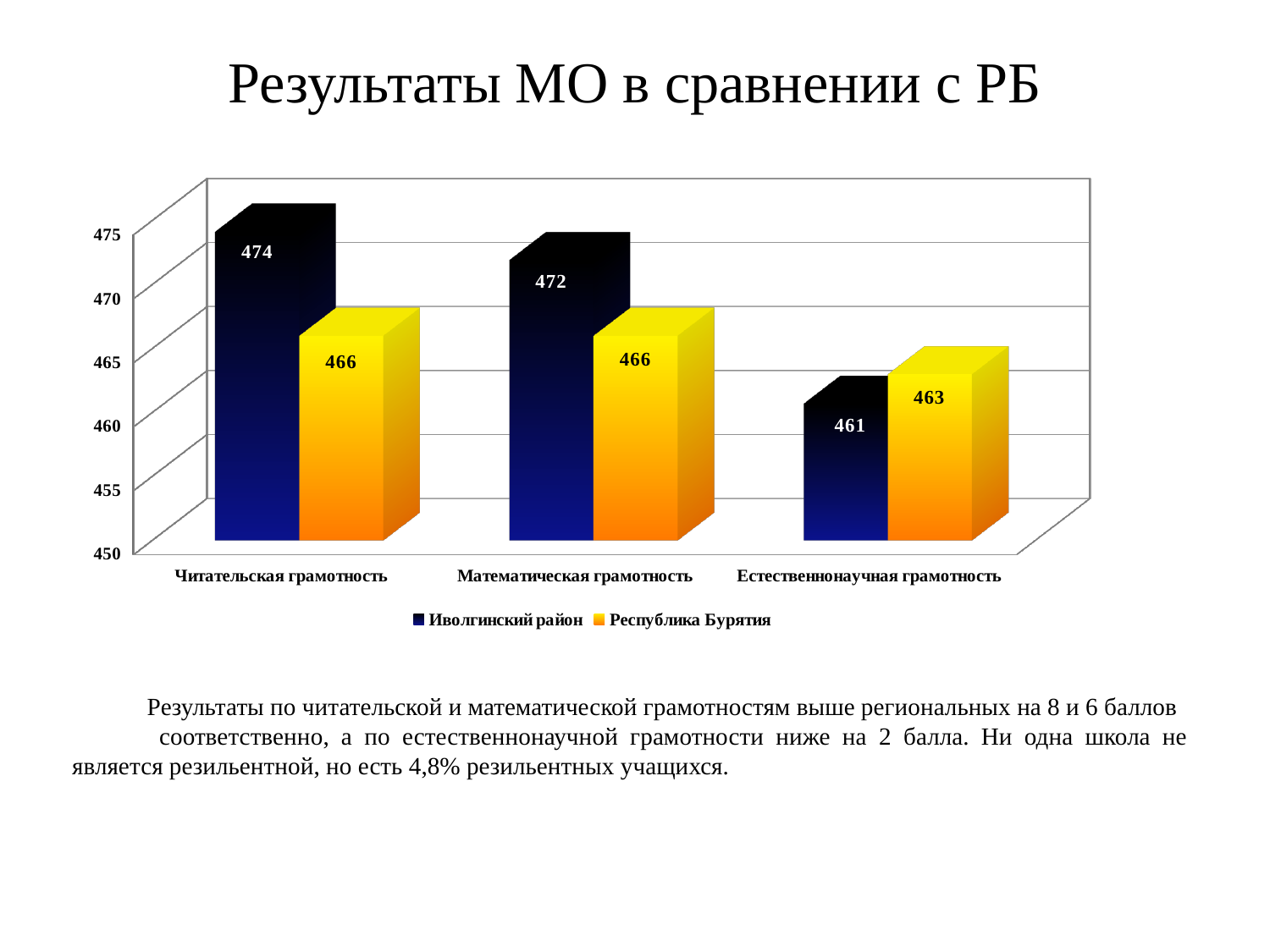
What kind of chart is shown on the slide? bar chart How many categories are shown on the x axis? 3 Is the value for Иволгинский район in Естественнонаучная грамотность greater or less than 465? less What is the value for Иволгинский район in Читательская грамотность? 474 What is the value for Иволгинский район in Математическая грамотность? 472 Which category has the highest value for Иволгинский район? Читательская грамотность What is the difference between Иволгинский район and Республика Бурятия in Читательская грамотность? 8 How many series does the legend list? 2 What is the title of the slide? Результаты МО в сравнении с РБ Which series has the larger value in Естественнонаучная грамотность, Иволгинский район or Республика Бурятия? Республика Бурятия What is the value for Республика Бурятия in Естественнонаучная грамотность? 463 Which category has the lowest value for Республика Бурятия? Естественнонаучная грамотность